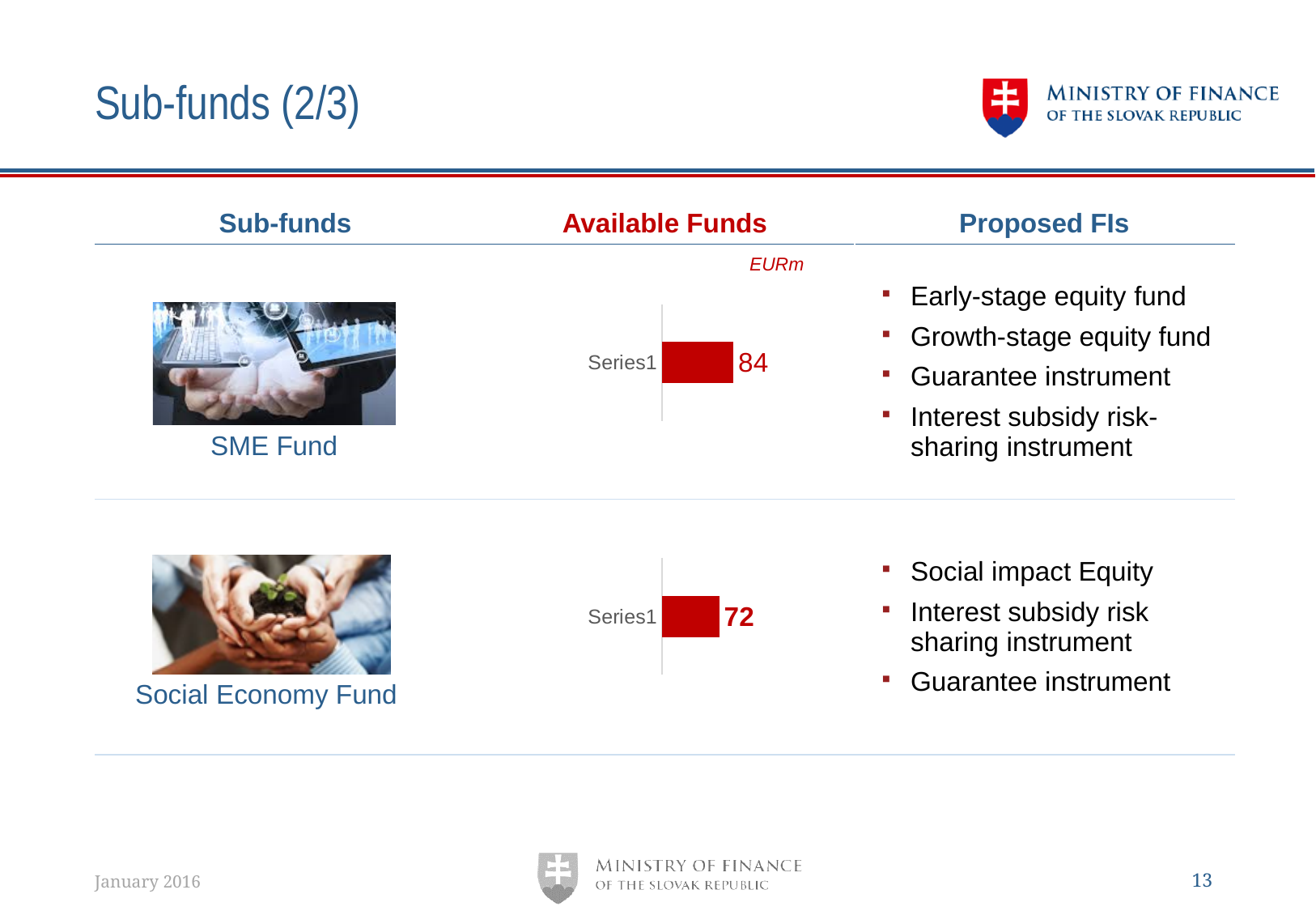
What kind of chart is shown in the SME Fund row? Bar chart What kind of chart is shown in the Social Economy Fund row? Bar chart How many bars does the chart in the Social Economy Fund row contain? 1 In the chart in the SME Fund row, what value is shown for Series1? 84 What is the difference between the value in the SME Fund row chart (84) and the value in the Social Economy Fund row chart (72)? 12 What unit is indicated above the charts in the Available Funds column? EURm In the chart in the Social Economy Fund row, what value is shown for Series1? 72 Which is larger: the Series1 value in the SME Fund row chart or the Series1 value in the Social Economy Fund row chart? SME Fund row chart How many bars does the chart in the SME Fund row contain? 1 What is the category label of the bar in the chart in the SME Fund row? Series1 What is the total of the values shown in the two charts (84 and 72)? 156